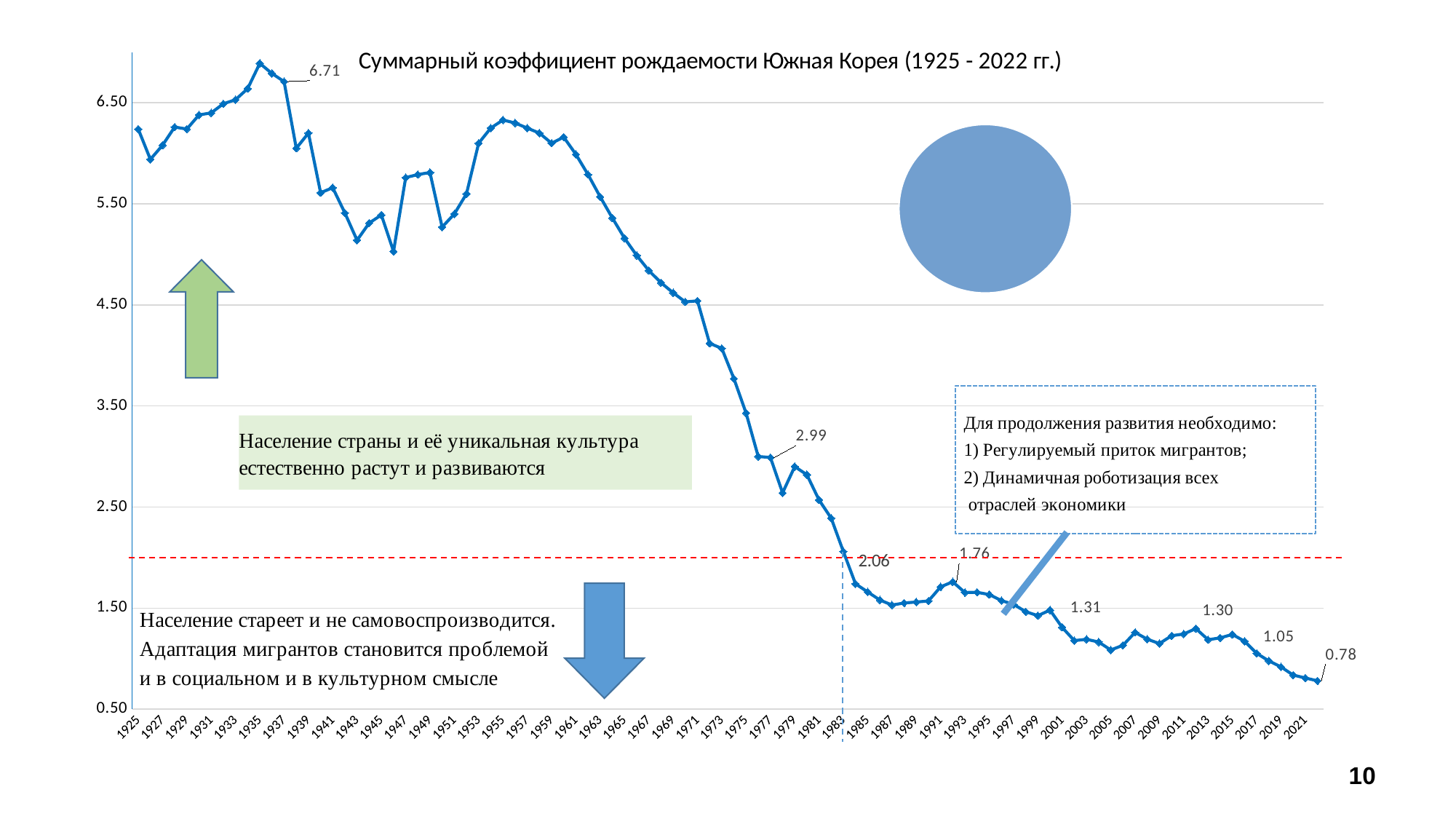
What is the title of the chart? Суммарный коэффициент рождаемости Южная Корея (1925 - 2022 гг.) What is the difference between the highest labelled value (6.71) and the lowest labelled value (0.78)? 5.93 Overall, do the values rise or fall from 1925 to 2022? fall What is the highest value labelled on the chart? 6.71 Is the value for 2005 greater or less than 1.50? less How many data points on the chart have printed value labels? 8 What value is labelled on the chart for 1992? 1.76 What kind of chart is shown on the slide? line chart Is the value for 1925 greater or less than 5.50? greater What is the lowest value labelled on the chart, at the final point (2022)? 0.78